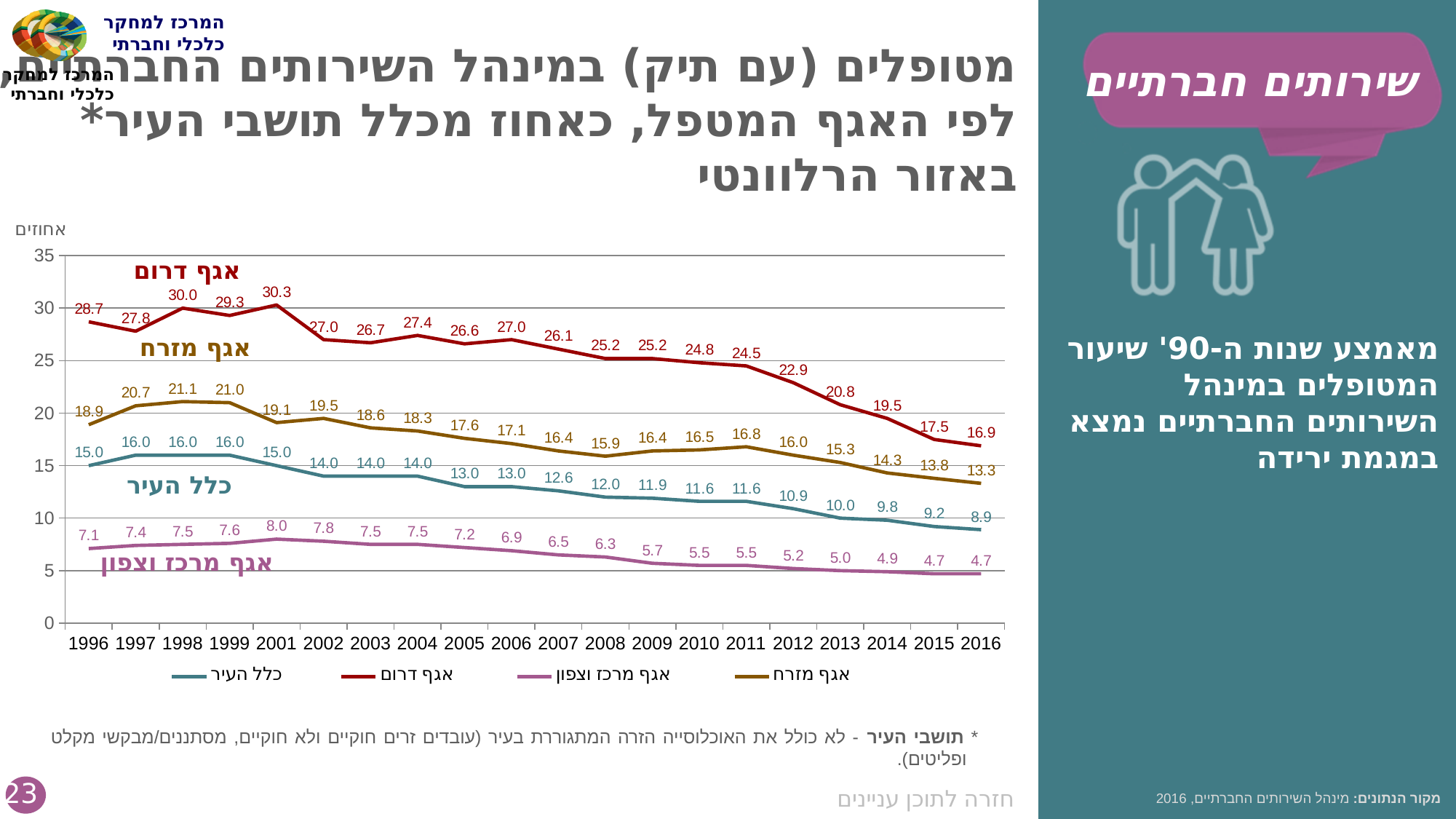
Does the value for כלל העיר rise or fall from 2001 to 2016? Fall How many years are shown on the x axis? 20 How many series does the legend list? 4 What is the value for אגף מזרח in 1998? 21.1 What is the value for אגף דרום in 2001? 30.3 What is the value for כלל העיר in 2008? 12.0 Which is larger in 2011: the value for אגף מזרח or the value for כלל העיר? אגף מזרח What is the difference between the אגף דרום value in 1996 and in 2016? 11.8 What kind of chart is shown on the slide? Line chart In which year does אגף דרום reach its highest value? 2001 What is the value for אגף מרכז וצפון in 2016? 4.7 In which year does אגף מזרח have its lowest value? 2016